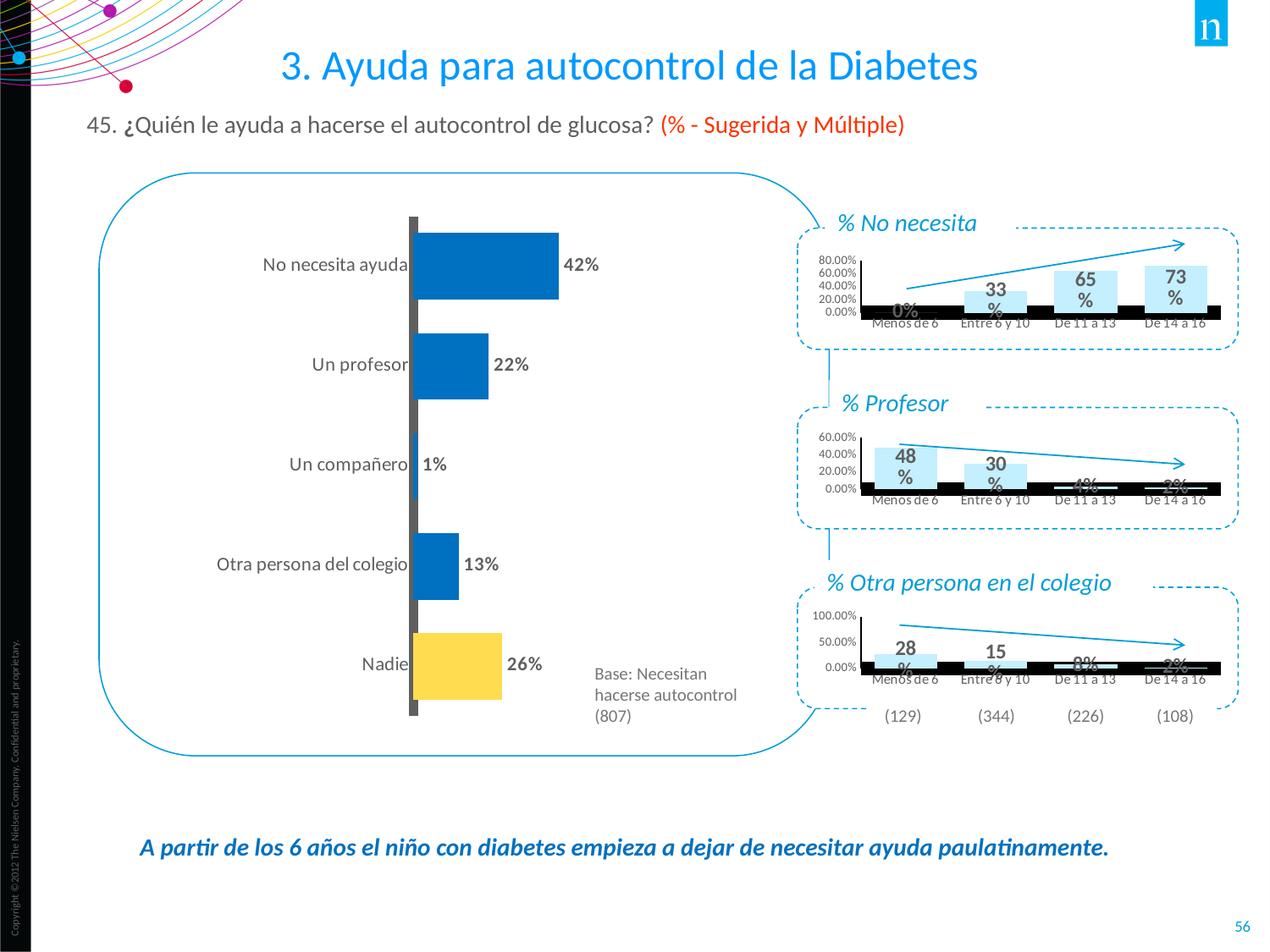
In the large bar chart on the left, which category has the highest value? No necesita ayuda In the '% Profesor' chart, do the values rise or fall from 'Menos de 6' to 'De 14 a 16'? Fall In the large bar chart on the left, what is the difference between 'Un profesor' and 'Otra persona del colegio'? 9% In the large bar chart on the left, how many categories are shown? 5 In the '% No necesita' chart, what is the value for 'De 14 a 16'? 73% In the '% No necesita' chart, do the values rise or fall from 'Menos de 6' to 'De 14 a 16'? Rise In the large bar chart on the left, what is the value for 'Nadie'? 26% In the large bar chart on the left, which category has the lowest value? Un compañero In the '% Otra persona en el colegio' chart, which is larger, 'Menos de 6' or 'Entre 6 y 10'? Menos de 6 In the '% Profesor' chart, what is the value for 'Menos de 6'? 48% In the large bar chart on the left, what is the value for 'No necesita ayuda'? 42% What type of chart is the large chart on the left? Bar chart